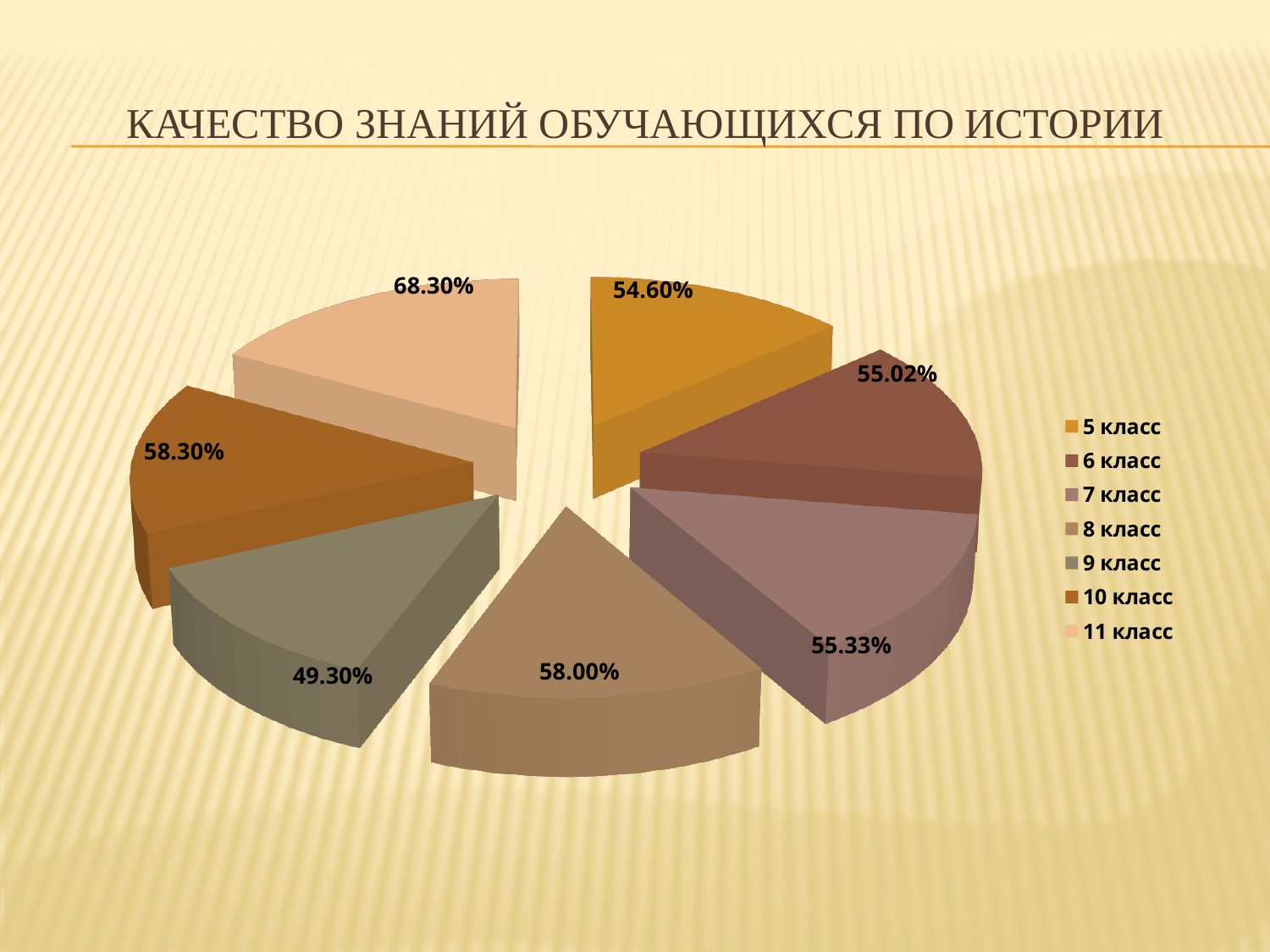
What kind of chart is shown on the slide? pie chart Which class has the highest value? 11 класс What is the difference between the values for 10 класс and 5 класс? 3.70% What is the value shown for 11 класс? 68.30% What is the difference between the values for 11 класс and 9 класс? 19.00% Which class has the lowest value? 9 класс Which is larger, the value for 8 класс or the value for 6 класс? 8 класс What is the value shown for 7 класс? 55.33% What is the title of the slide? КАЧЕСТВО ЗНАНИЙ ОБУЧАЮЩИХСЯ ПО ИСТОРИИ What is the value shown for 9 класс? 49.30% What is the value shown for 5 класс? 54.60% How many classes are shown in the chart? 7